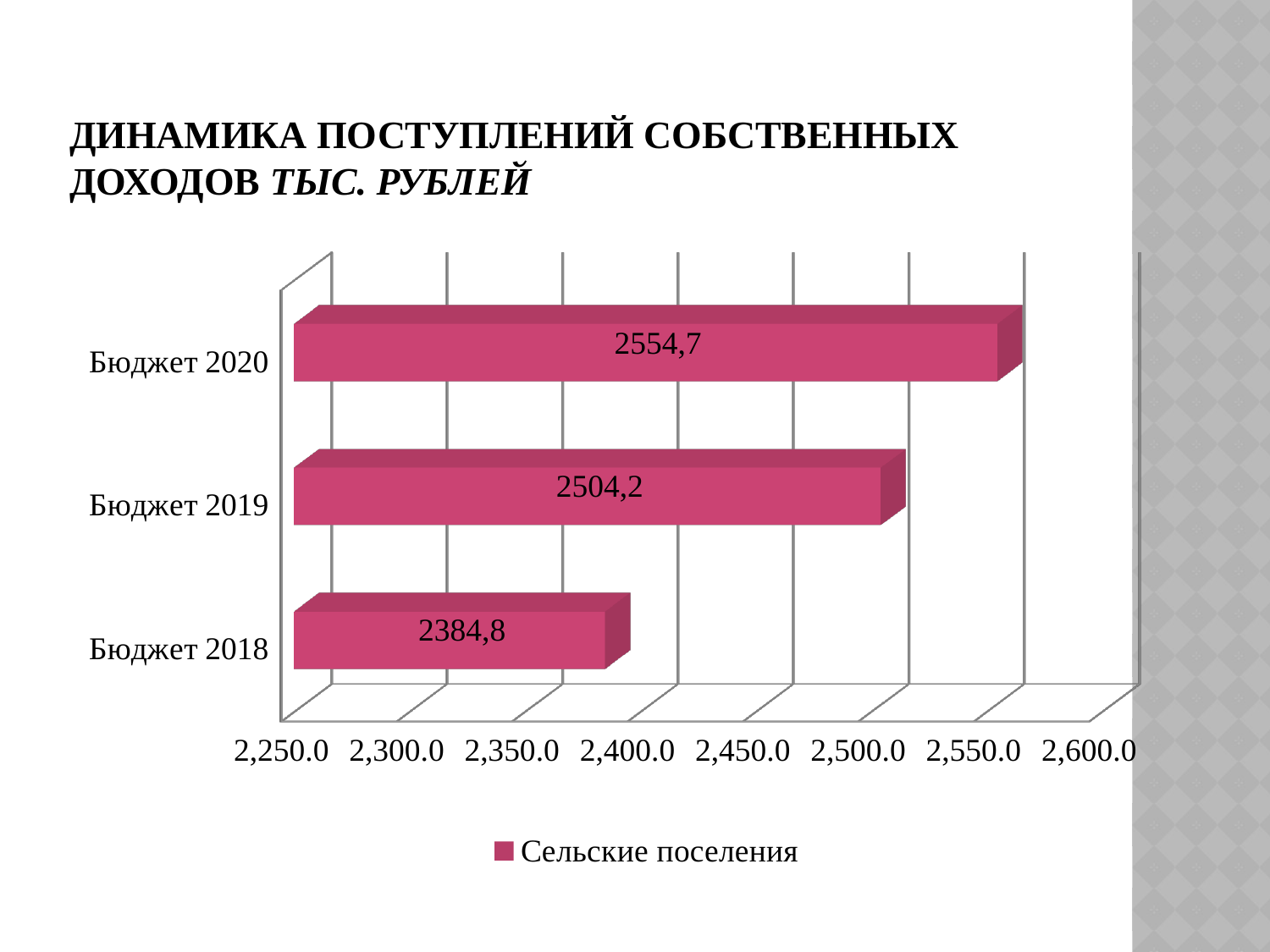
What is the value for Бюджет 2018? 2384,8 What is the difference between the values for Бюджет 2020 and Бюджет 2018? 169,9 Which category has the highest value? Бюджет 2020 What kind of chart is shown on the slide? bar chart What is the value for Бюджет 2019? 2504,2 Which category has the lowest value? Бюджет 2018 How many categories are shown in the chart? 3 What is the difference between the values for Бюджет 2020 and Бюджет 2019? 50,5 Is the value for Бюджет 2018 greater or less than 2,400.0? less How many series does the legend list? 1 What is the value for Бюджет 2020? 2554,7 Which is larger, the value for Бюджет 2019 or Бюджет 2018? Бюджет 2019